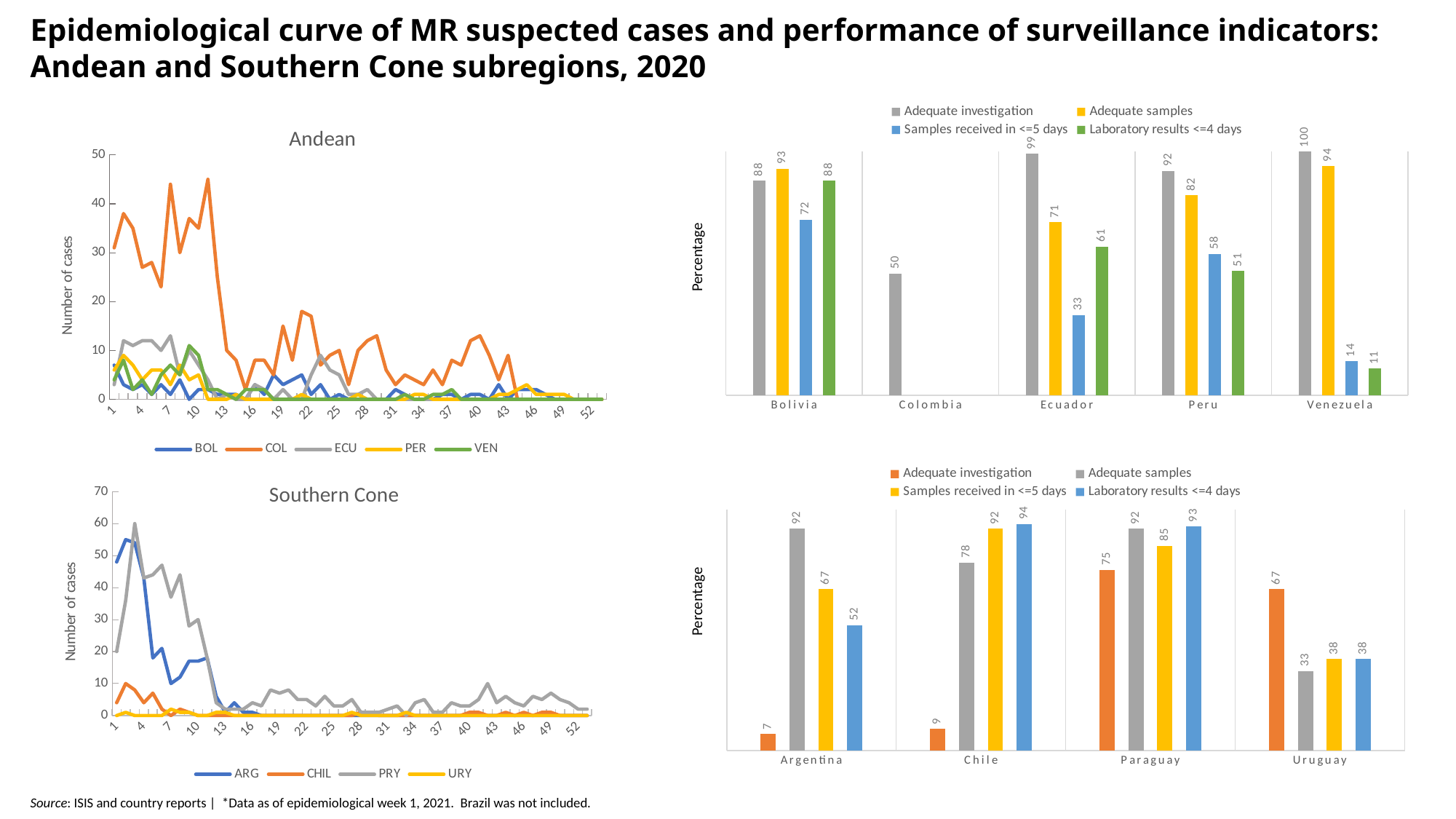
In the bottom-right bar chart, what colour represents Adequate investigation? orange How many series does the legend of the bottom-right bar chart list? 4 In the bottom-right bar chart, which is larger: the Laboratory results <=4 days value for Argentina or for Uruguay? Argentina In the bottom-right bar chart, which country has the lowest Adequate samples value? Uruguay In the top-right bar chart, what is the Adequate investigation value for Venezuela? 100 How many countries are shown on the x axis of the top-right bar chart? 5 In the top-right bar chart, which country has the highest Adequate investigation value? Venezuela What kind of chart is the Andean chart on the top left? line chart In the bottom-right bar chart, what is the Adequate investigation value for Argentina? 7 In the top-right bar chart, what is the difference between Ecuador's Adequate investigation value and its Samples received in <=5 days value? 66 In the top-right bar chart, what is the Adequate investigation value for Colombia? 50